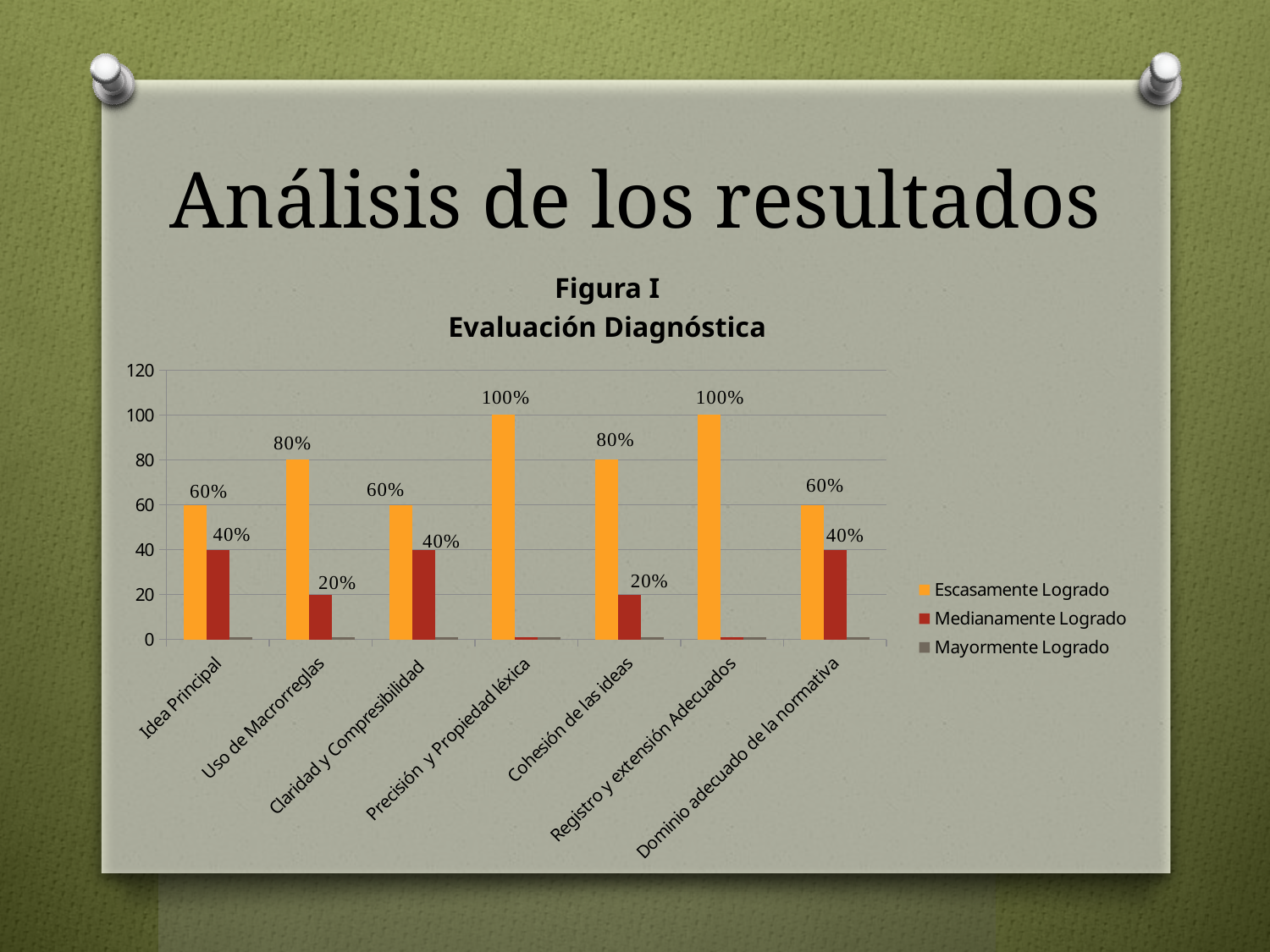
Is the Escasamente Logrado value for Uso de Macrorreglas greater or less than 60? greater How many categories are shown on the x axis? 7 What is the value of Escasamente Logrado for Precisión y Propiedad léxica? 100% What is the value of Medianamente Logrado for Uso de Macrorreglas? 20% What is the difference between the Escasamente Logrado and Medianamente Logrado values for Cohesión de las ideas? 60% Which is larger for Claridad y Compresibilidad: Escasamente Logrado or Medianamente Logrado? Escasamente Logrado What is the title of the chart? Figura I Evaluación Diagnóstica How many series does the legend list? 3 Which categories have the highest Escasamente Logrado value? Precisión y Propiedad léxica and Registro y extensión Adecuados What is the value of Escasamente Logrado for Idea Principal? 60% What is the value of Medianamente Logrado for Dominio adecuado de la normativa? 40% What kind of chart is shown on the slide? Bar chart